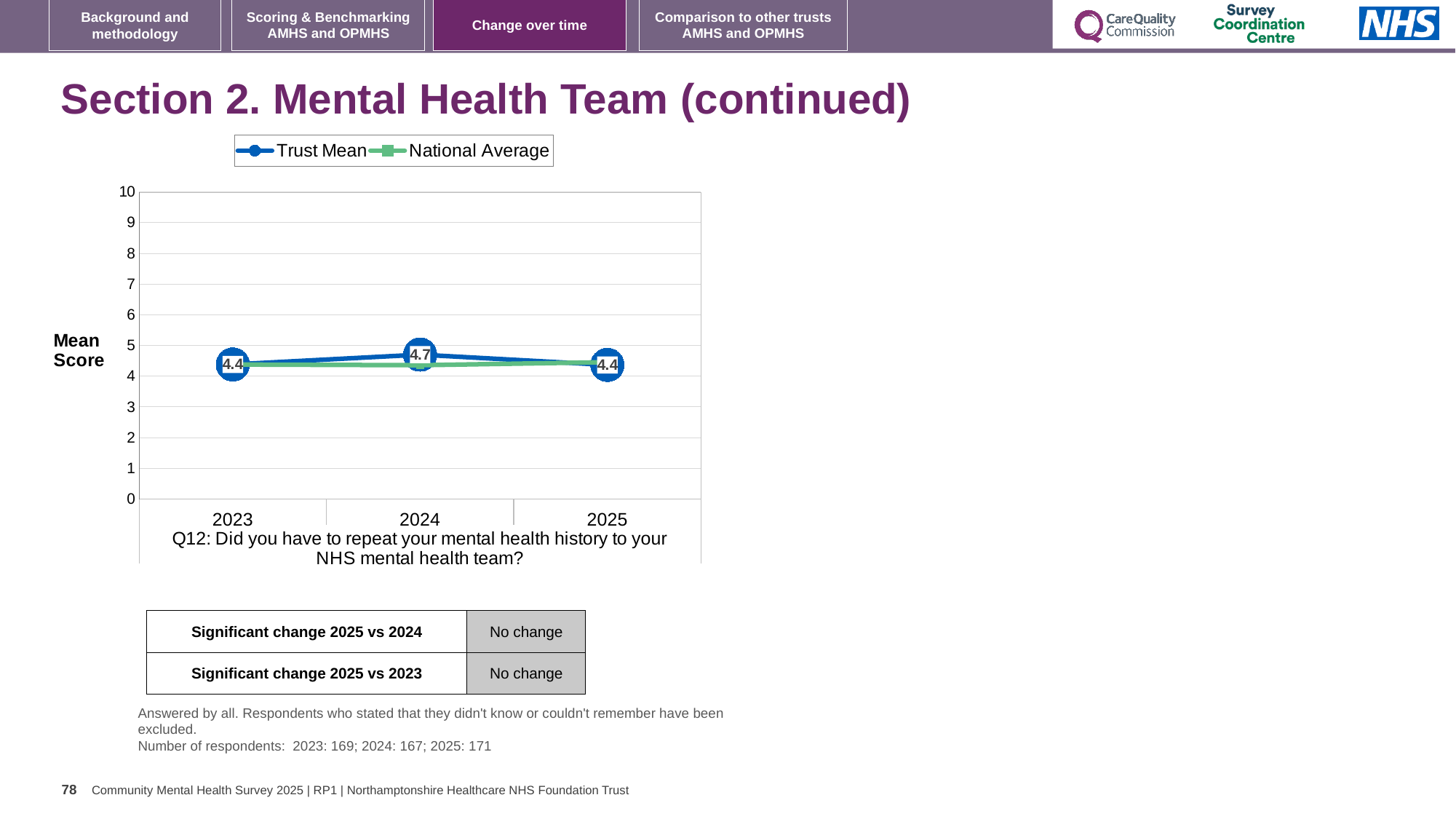
What is the difference between the Trust Mean in 2024 and in 2023? 0.3 Does the Trust Mean rise or fall from 2024 to 2025? Fall What is the Trust Mean score for 2023? 4.4 How many series does the legend list? 2 What is the Trust Mean score for 2024? 4.7 Is the Trust Mean for 2024 larger than the Trust Mean for 2025? Yes How many years are shown on the x axis? 3 What is the Trust Mean score for 2025? 4.4 Is the National Average value for 2024 greater or less than 5? less What is the label on the y axis of the chart? Mean Score What kind of chart is shown on the slide? Line chart In which year is the Trust Mean highest? 2024